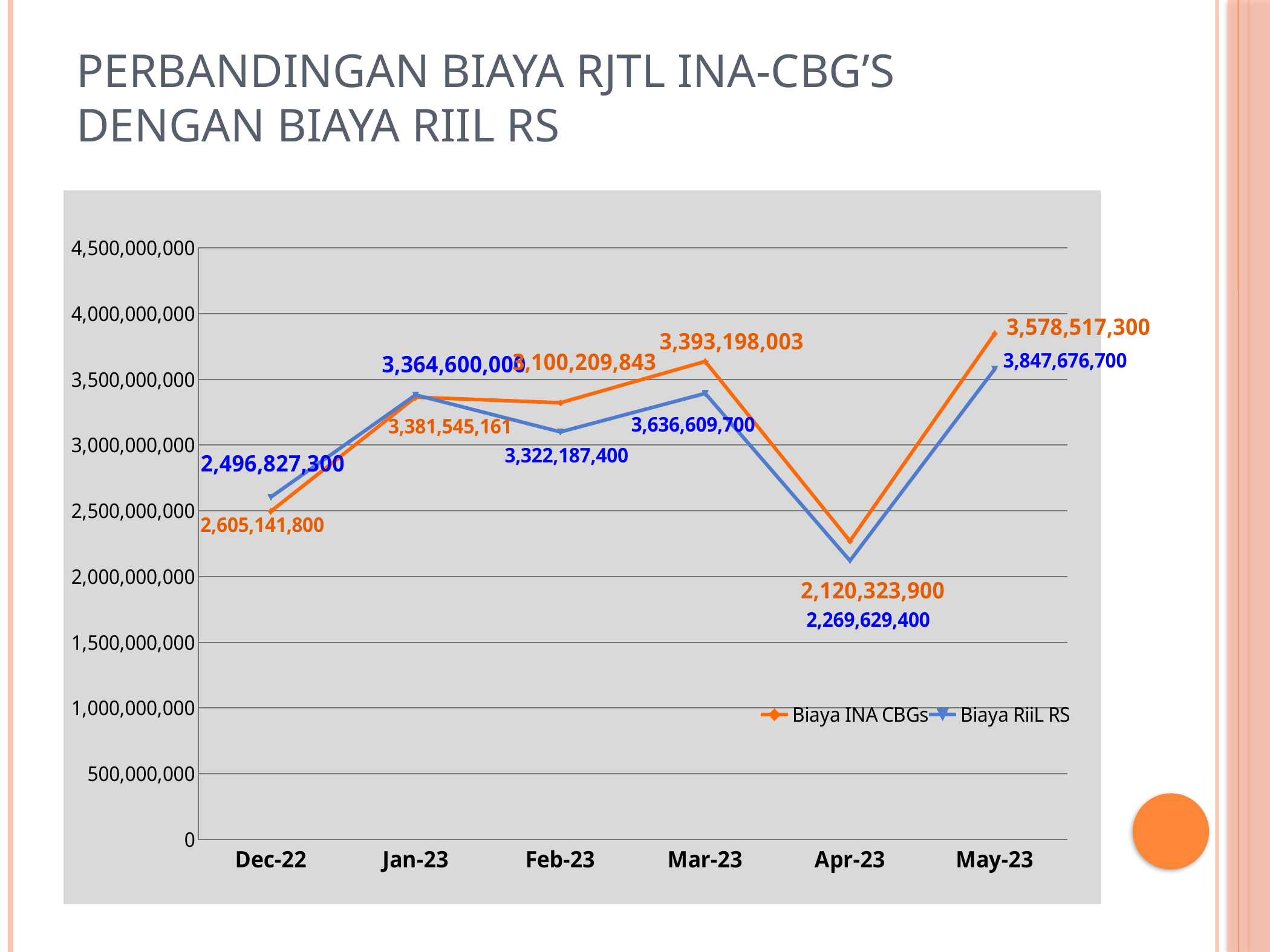
What is the value labelled for Biaya RiiL RS in Mar-23? 3,636,609,700 How many series does the legend list? 2 What is the difference between the Biaya INA CBGs values for May-23 and Apr-23? 1,458,193,400 What is the value labelled for Biaya RiiL RS in Apr-23? 2,269,629,400 What kind of chart is shown on the slide? line chart In which month is the Biaya RiiL RS value highest? May-23 Is the Biaya RiiL RS value for Apr-23 greater or less than 2,500,000,000? less What is the value labelled for Biaya INA CBGs in Dec-22? 2,605,141,800 How many months are plotted along the x axis? 6 Do both series rise or fall from Mar-23 to Apr-23? fall In which month is the Biaya INA CBGs value lowest? Apr-23 What is the value labelled for Biaya INA CBGs in May-23? 3,578,517,300